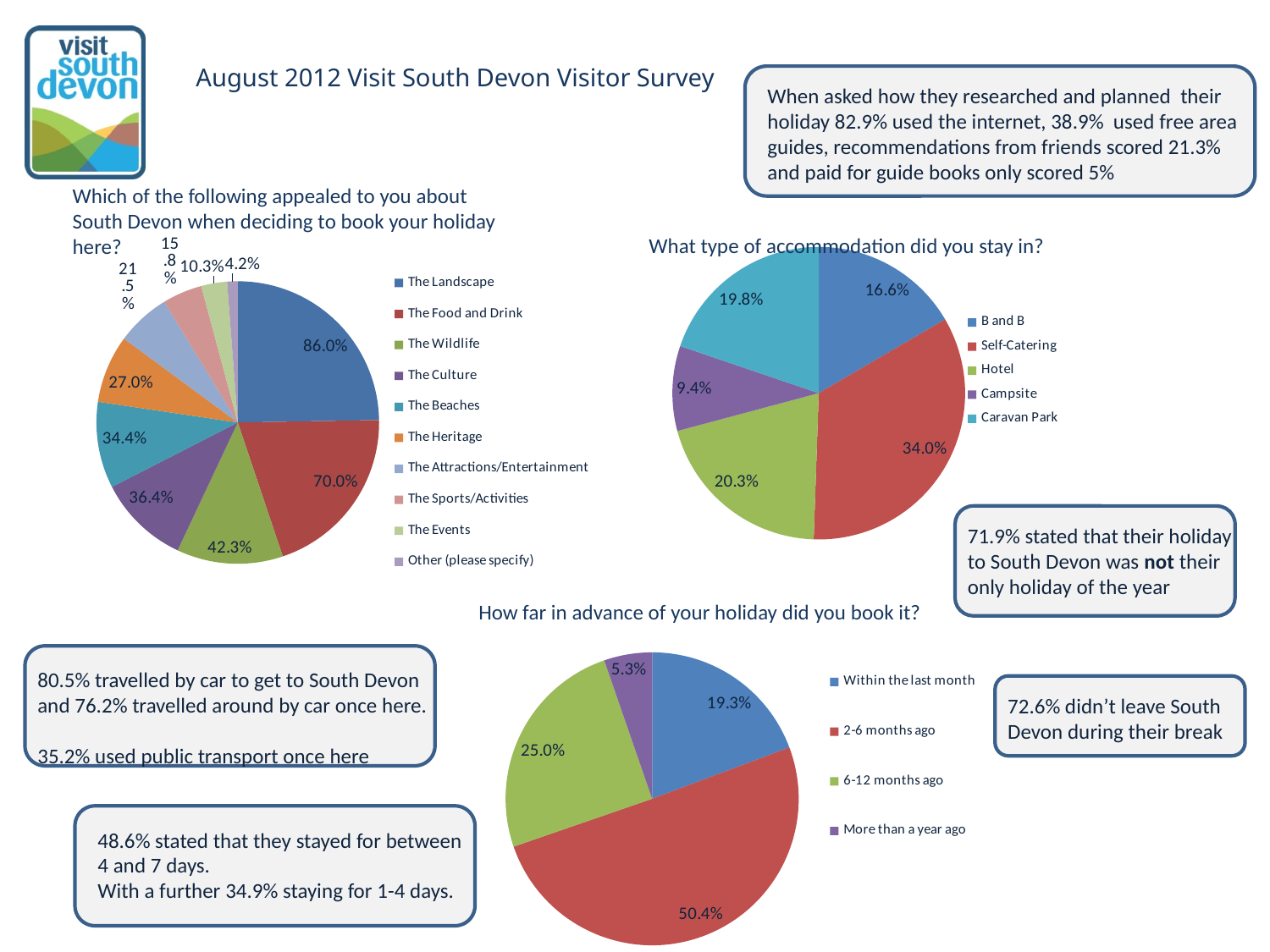
In the 'What type of accommodation did you stay in?' chart, what is the difference between the Hotel and B and B percentages? 3.7% In the 'Which of the following appealed to you about South Devon' chart, which is larger: The Wildlife or The Beaches? The Wildlife In the 'Which of the following appealed to you about South Devon' chart, what percentage is shown for The Landscape? 86.0% In the 'Which of the following appealed to you about South Devon' chart, how many categories does the legend list? 10 In the 'What type of accommodation did you stay in?' chart, which accommodation type has the smallest share? Campsite In the 'What type of accommodation did you stay in?' chart, how many accommodation types are shown in the legend? 5 In the 'How far in advance of your holiday did you book it?' chart, what percentage booked more than a year ago? 5.3% In the 'How far in advance of your holiday did you book it?' chart, what percentage booked 2-6 months ago? 50.4% What kind of chart is used for 'How far in advance of your holiday did you book it?' Pie chart In the 'What type of accommodation did you stay in?' chart, what percentage stayed in Self-Catering accommodation? 34.0% In the 'How far in advance of your holiday did you book it?' chart, which booking period has the largest share? 2-6 months ago In the 'Which of the following appealed to you about South Devon' chart, what percentage is shown for The Heritage? 27.0%